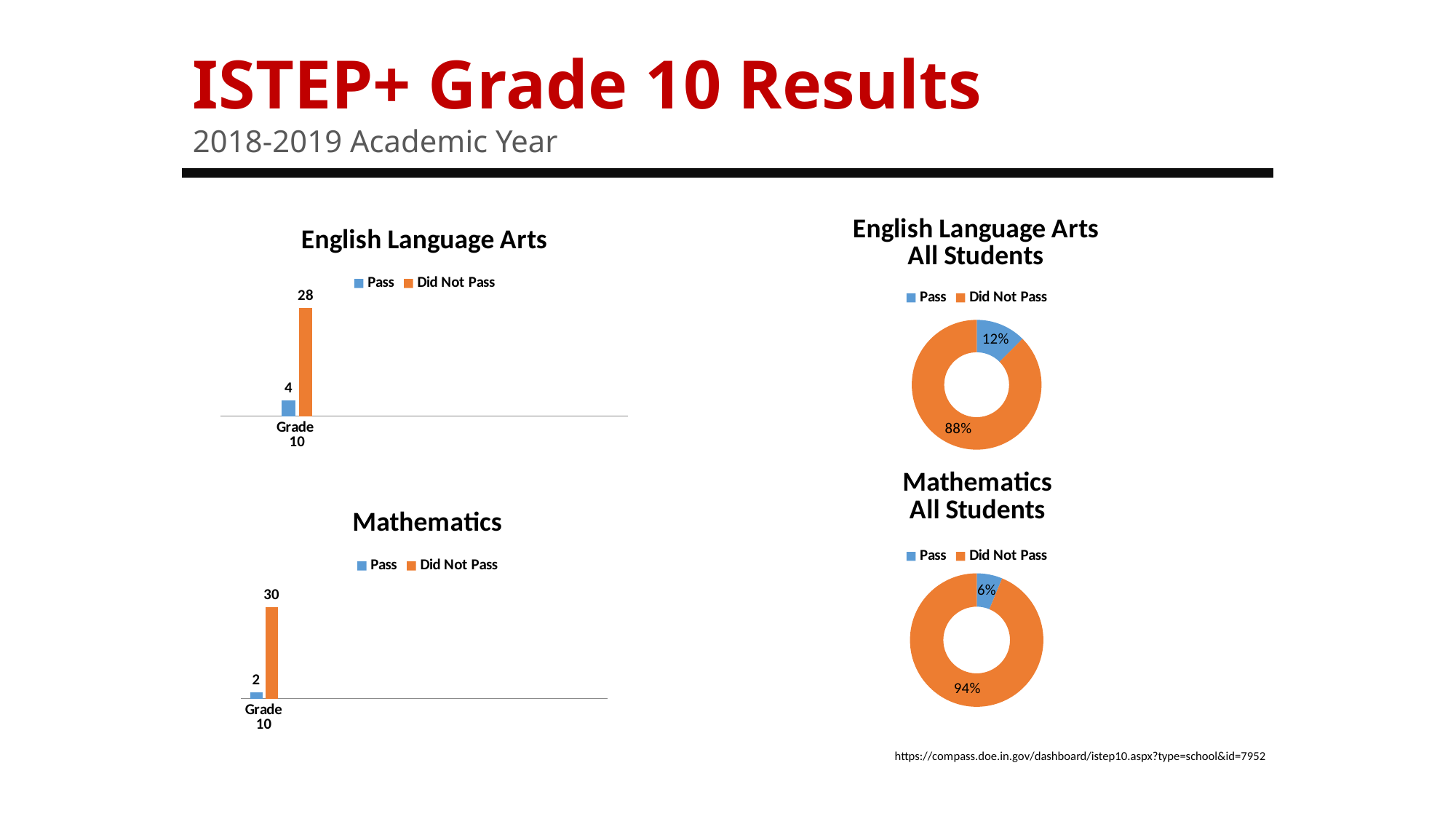
In the Mathematics All Students chart, what share of students is Pass? 6% In the English Language Arts bar chart, what is the value for Did Not Pass? 28 What kind of chart is the Mathematics chart on the left of the slide? Bar chart In the English Language Arts bar chart, what is the value for Pass? 4 In the English Language Arts bar chart, what is the difference between Did Not Pass and Pass? 24 What kind of chart is the English Language Arts All Students chart? Doughnut chart In the Mathematics All Students chart, what share of students is Did Not Pass? 94% In the Mathematics bar chart, what is the value for Pass? 2 In the Mathematics bar chart, what is the value for Did Not Pass? 30 In the English Language Arts All Students chart, what share of students is Pass? 12% In the Mathematics bar chart, what is the difference between Did Not Pass and Pass? 28 How many series does the legend of the Mathematics bar chart list? 2